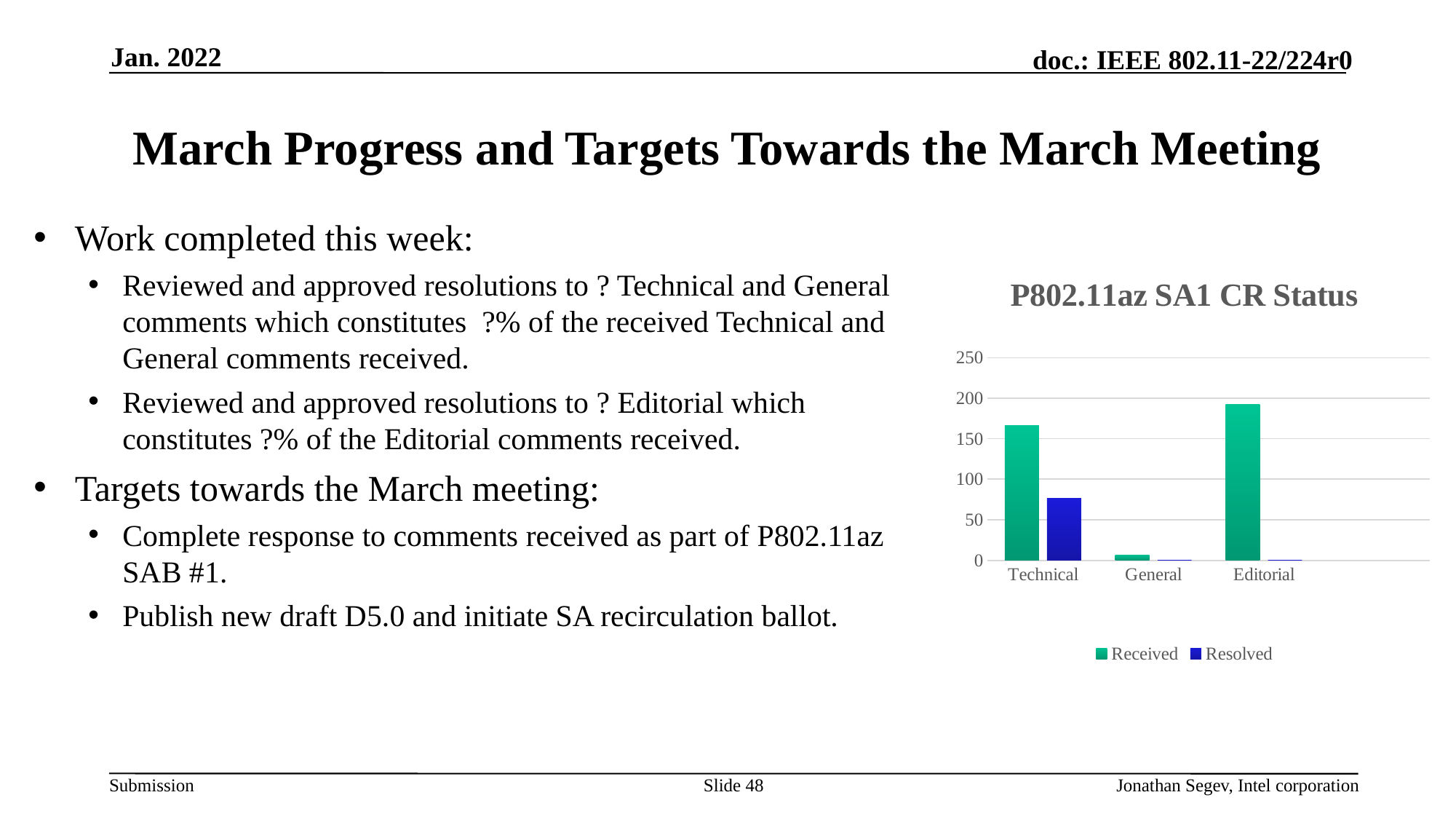
Is the Received value for General greater or less than 50? less What type of chart is shown on the slide? bar chart How many series does the chart legend list? 2 Is the Resolved value for Technical greater or less than 100? less What is the title of the chart? P802.11az SA1 CR Status Which is larger for Technical: the Received value or the Resolved value? Received Which category has the highest Received value? Editorial Is the Received value for Editorial greater or less than 200? less How many categories are shown on the x axis of the chart? 3 Which series is shown in blue in the chart? Resolved Which category has the lowest Received value? General